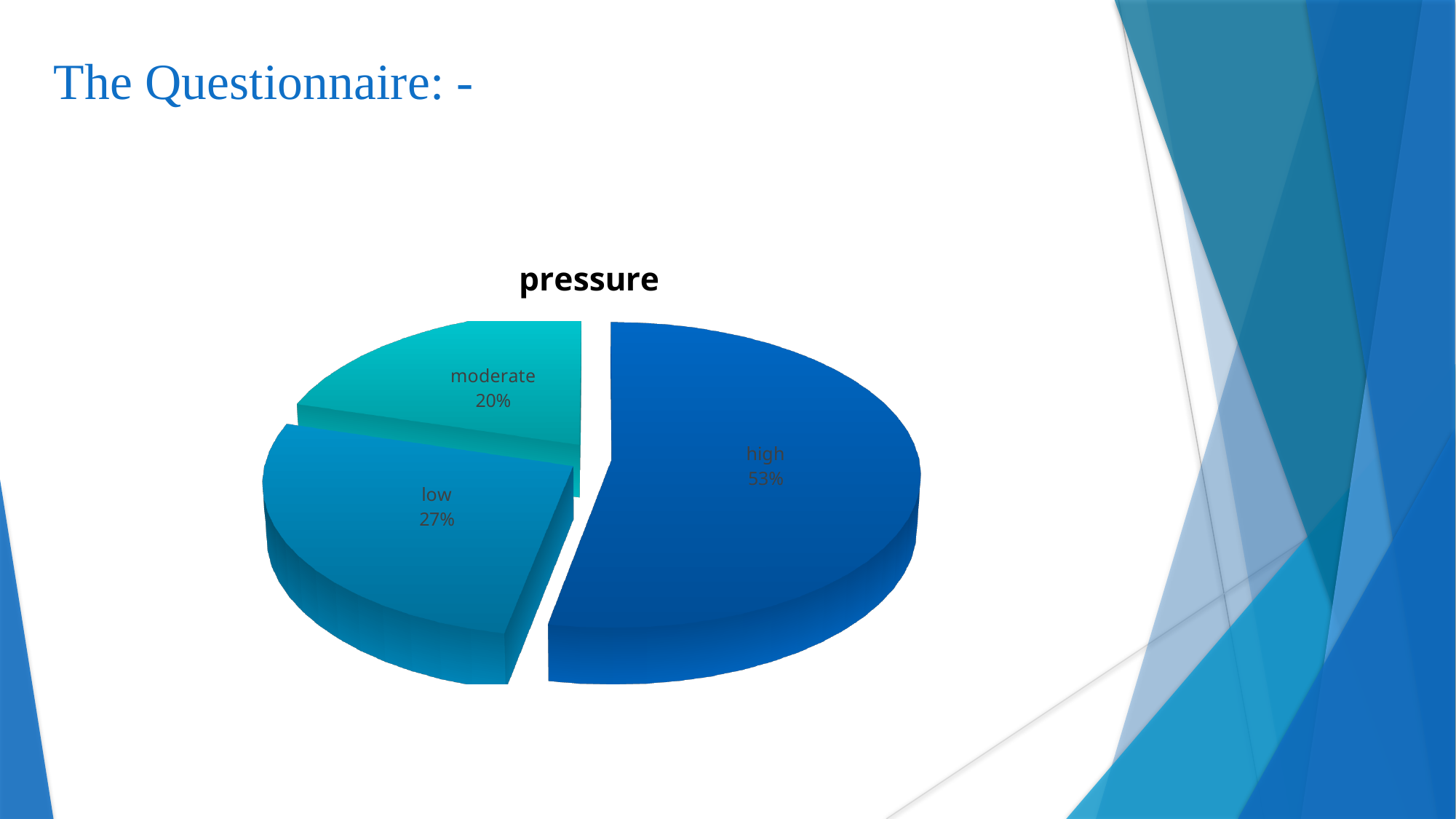
What share of the pie does the 'high' slice represent? 53% Is the share for 'high' greater or less than 50%? greater What share of the pie does the 'moderate' slice represent? 20% How many slices does the pie chart have? 3 Which slice is larger, 'low' or 'moderate'? low What share of the pie does the 'low' slice represent? 27% What is the difference in percentage points between the 'high' and 'low' slices? 26 What is the difference in percentage points between the 'low' and 'moderate' slices? 7 What kind of chart is shown on the slide? pie chart Which category has the largest slice of the pie? high Which category has the smallest slice of the pie? moderate What is the title of the chart? pressure